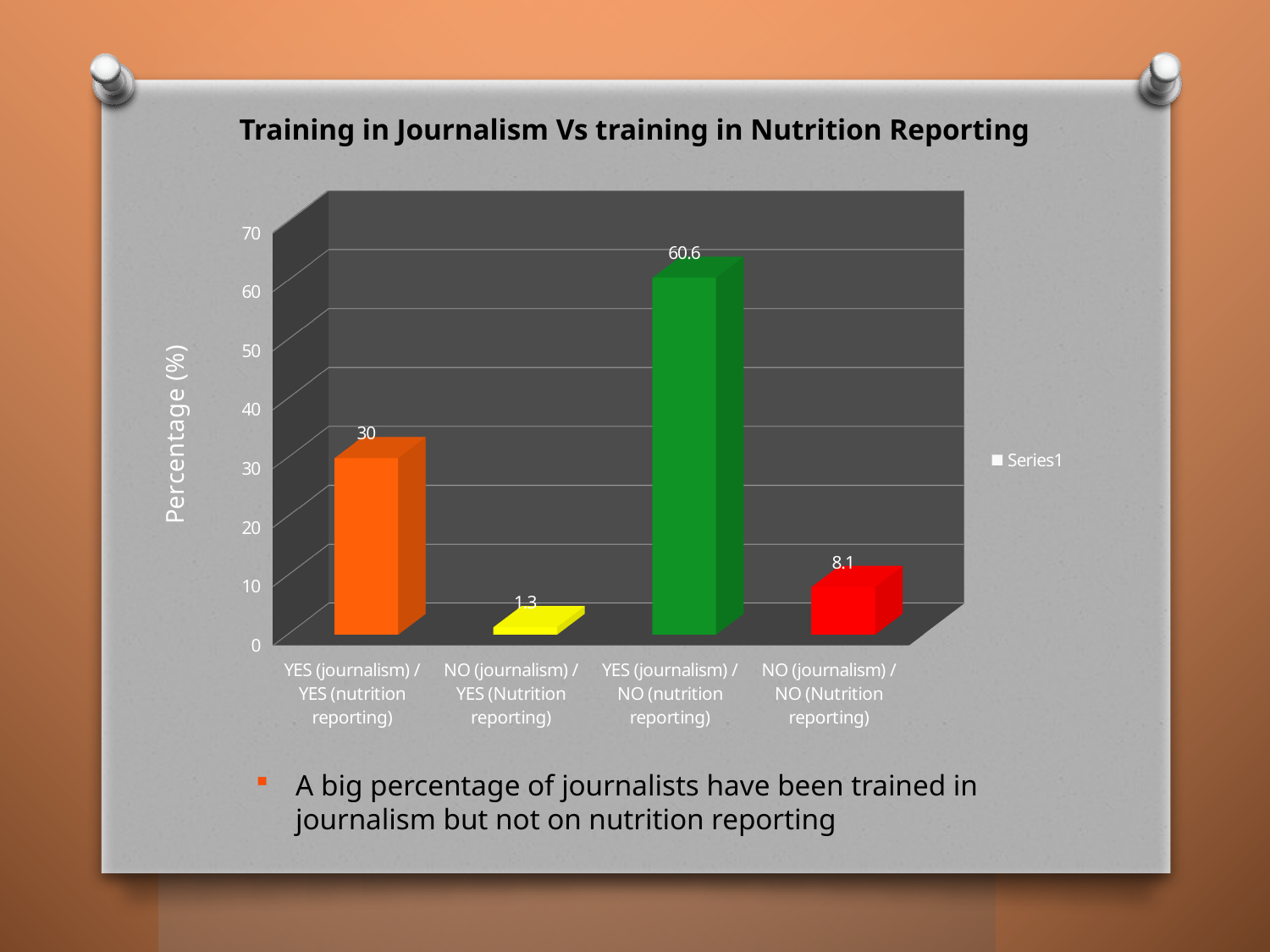
What is the value for NO (journalism) / YES (Nutrition reporting)? 1.3 Which is larger, the value for YES (journalism) / YES (nutrition reporting) or the value for NO (journalism) / NO (Nutrition reporting)? YES (journalism) / YES (nutrition reporting) What is the value for YES (journalism) / NO (nutrition reporting)? 60.6 What kind of chart is shown on the slide? bar chart Which category has the highest value? YES (journalism) / NO (nutrition reporting) What is the value for NO (journalism) / NO (Nutrition reporting)? 8.1 What is the difference between the values for YES (journalism) / NO (nutrition reporting) and YES (journalism) / YES (nutrition reporting)? 30.6 Is the value for YES (journalism) / NO (nutrition reporting) greater or less than 50? greater How many categories are shown on the x axis? 4 What is the title of the chart? Training in Journalism Vs training in Nutrition Reporting What is the value for YES (journalism) / YES (nutrition reporting)? 30 Which category has the lowest value? NO (journalism) / YES (Nutrition reporting)